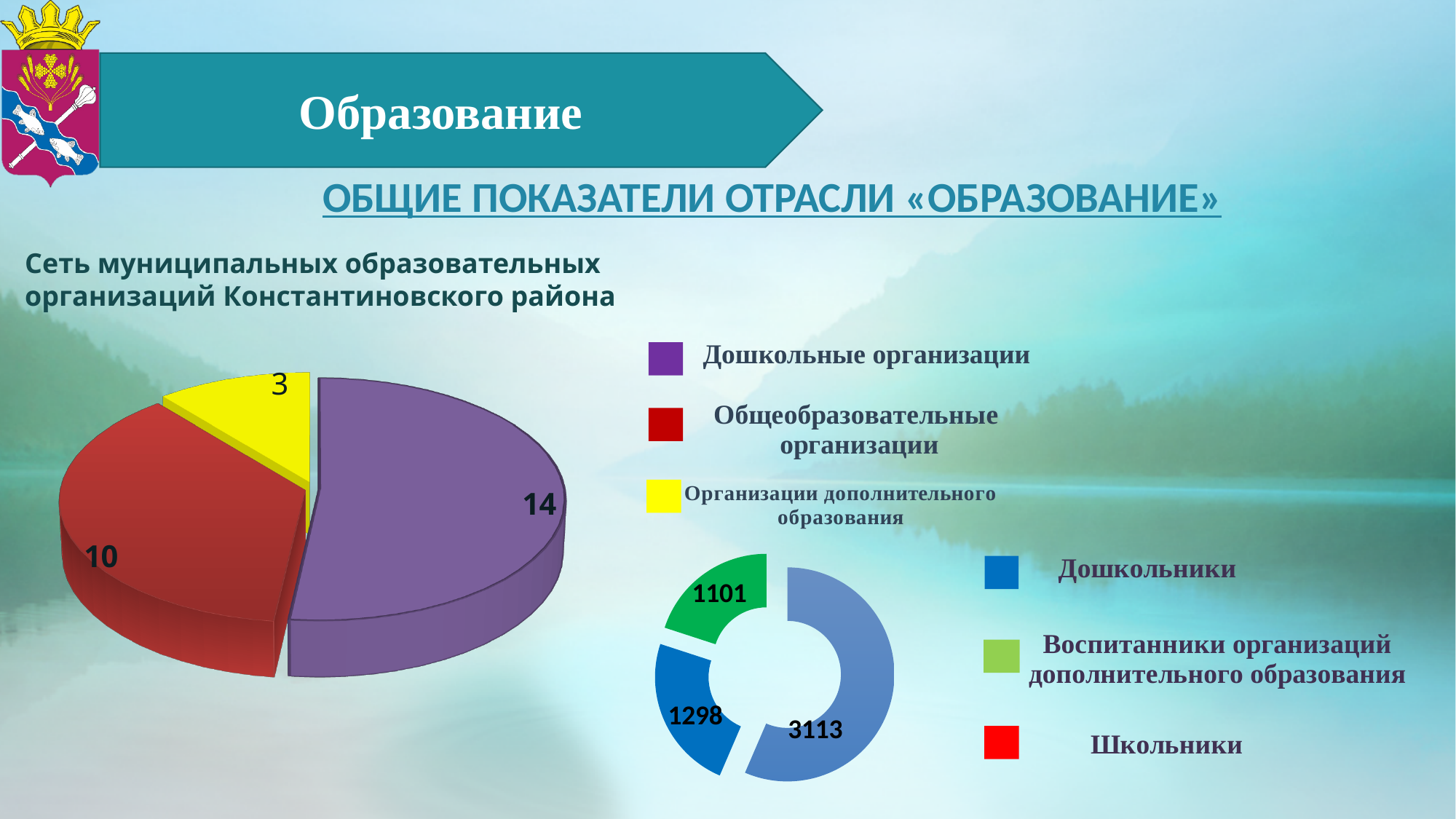
In the doughnut chart on the right, what is the difference between the largest value (3113) and the value 1298? 1815 In the pie chart on the left, which category has the largest slice? Дошкольные организации How many entries does the legend of the doughnut chart on the right list? 3 In the doughnut chart on the right, what is the smallest value shown? 1101 In the pie chart on the left, how many slices are there? 3 In the pie chart on the left, what is the value for Организации дополнительного образования? 3 In the pie chart on the left, what is the value for Дошкольные организации? 14 What kind of chart is the chart on the left of the slide? Pie chart In the pie chart on the left, what is the difference between the values for Дошкольные организации and Общеобразовательные организации? 4 In the pie chart on the left, what is the value for Общеобразовательные организации? 10 In the pie chart on the left, which category has the smallest slice? Организации дополнительного образования In the doughnut chart on the right, what is the largest value shown? 3113